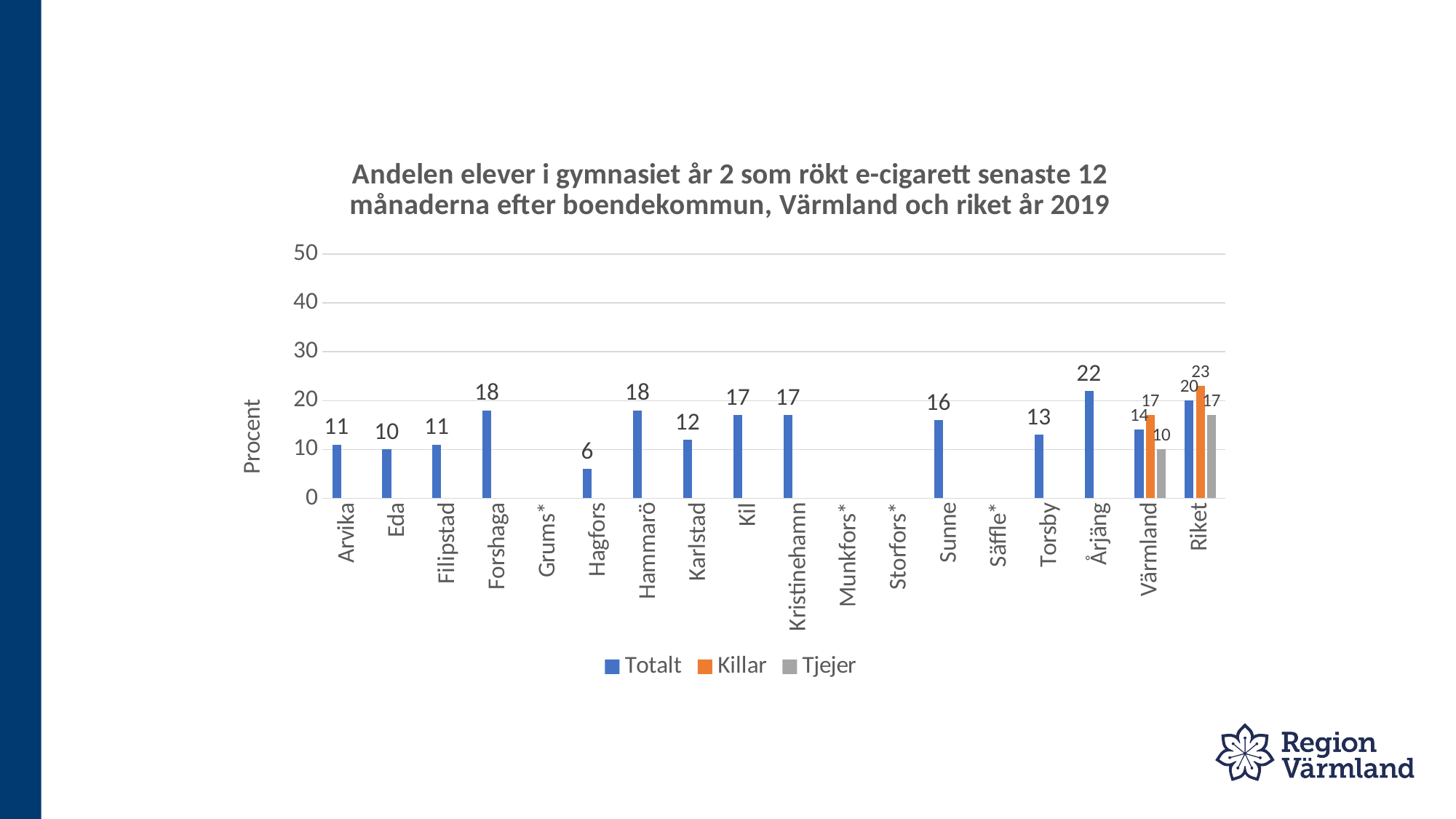
What is the label on the vertical axis? Procent What is the Totalt value for Hagfors? 6 Which is larger, the Totalt value for Forshaga or the Totalt value for Karlstad? Forshaga How many series does the legend list? 3 What kind of chart is shown on the slide? Bar chart What is the difference between the Killar and Tjejer values for Riket? 6 What is the Tjejer value for Värmland? 10 Which municipality with a plotted bar has the lowest Totalt value? Hagfors Which municipality has the highest Totalt value? Årjäng What is the Killar value for Riket? 23 Is the Totalt value for Riket greater or less than 10? greater What is the Totalt value for Årjäng? 22